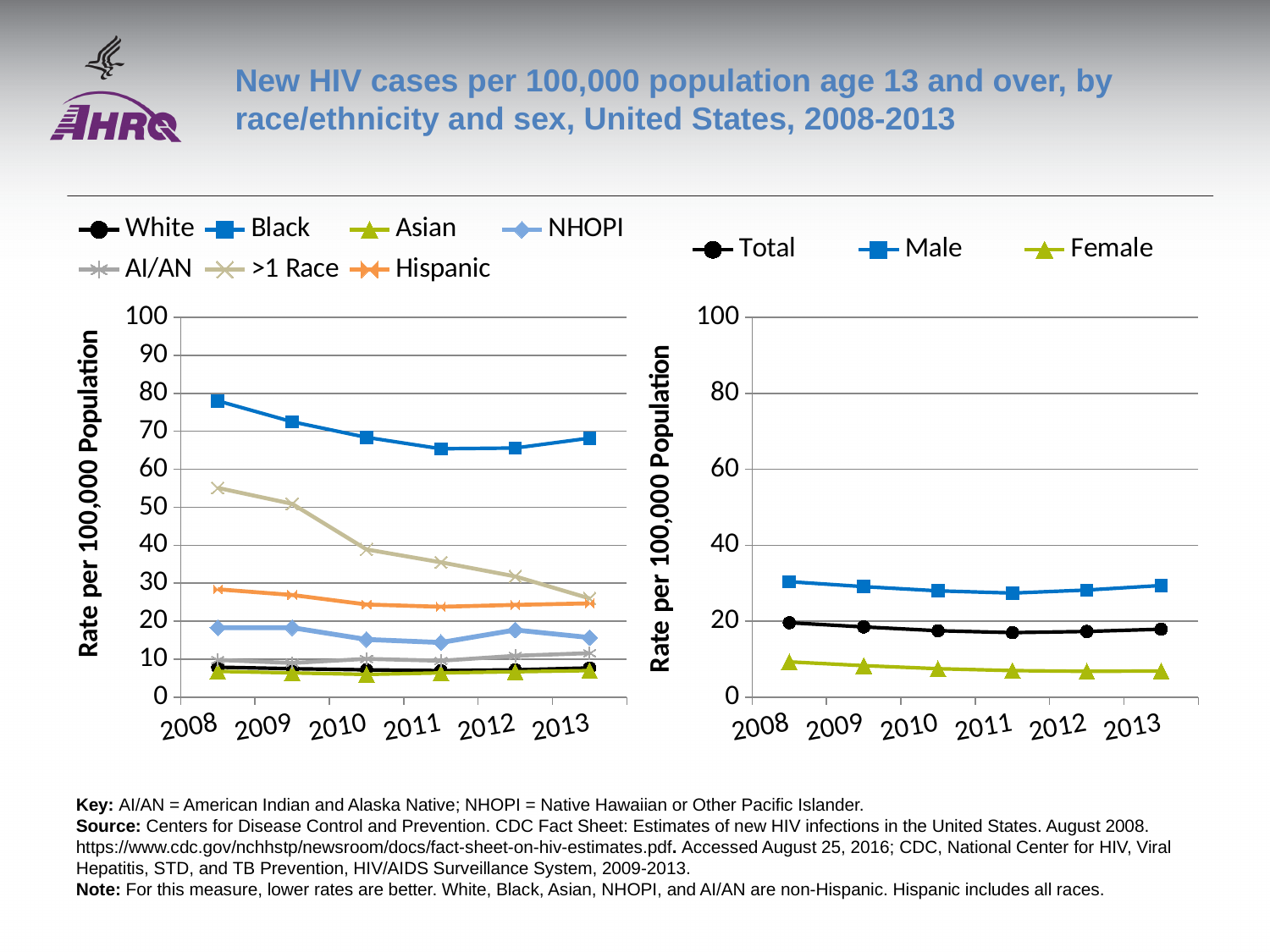
In the left chart (by race/ethnicity), is the value for Black in 2008 greater or less than 70? greater In the right chart (by sex), how many years are shown on the x axis? 6 In the left chart (by race/ethnicity), which group has the highest rate in 2008? Black In the right chart (by sex), how many series does the legend list? 3 In the right chart (by sex), which series has the lowest rates across all years? Female In the left chart (by race/ethnicity), does the rate for >1 Race rise or fall from 2008 to 2013? fall What type of chart is the left chart showing rates by race/ethnicity? Line chart In the left chart (by race/ethnicity), how many series does the legend list? 7 What is the y-axis label on the right chart (by sex)? Rate per 100,000 Population In the right chart (by sex), is the value for Female in 2013 greater or less than 20? less In the left chart (by race/ethnicity), which is larger in 2013, the rate for Black or the rate for Hispanic? Black In the right chart (by sex), is the value for Male in 2008 greater or less than 20? greater